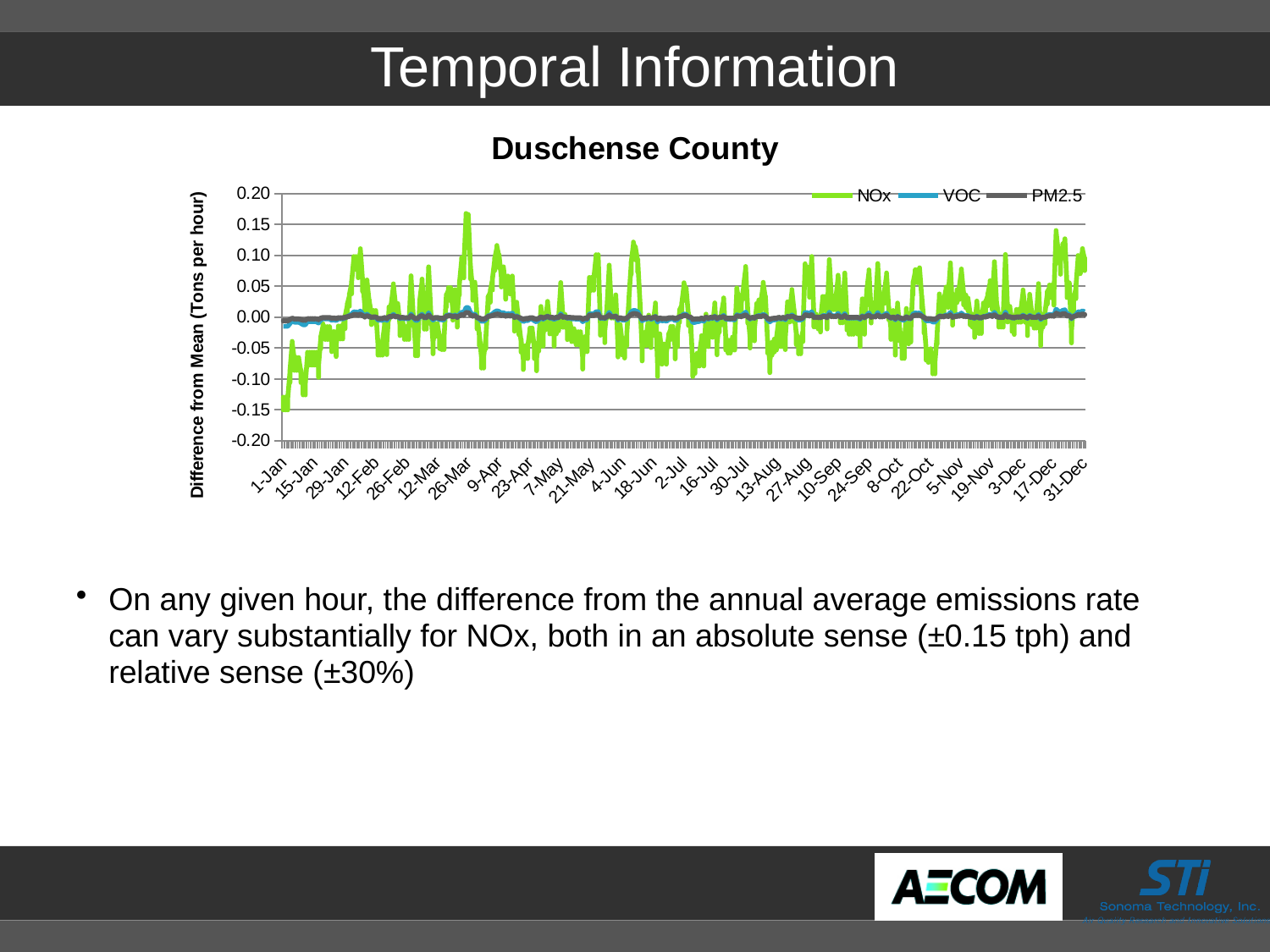
Which series reaches the highest value on the chart? NOx Is the highest NOx value on the chart greater or less than 0.15? greater What kind of chart is shown on the slide? Line chart Which series stays closest to 0.00 throughout the year, NOx or PM2.5? PM2.5 Is the highest PM2.5 value on the chart greater or less than 0.05? less Which series reaches the lowest value on the chart? NOx How many series does the chart's legend list? 3 What is the title of the chart? Duschense County Is the NOx value at 1-Jan greater or less than -0.10? less Which series shows larger swings away from zero, NOx or VOC? NOx What is the label of the vertical axis? Difference from Mean (Tons per hour) What is the maximum value shown on the vertical axis? 0.20